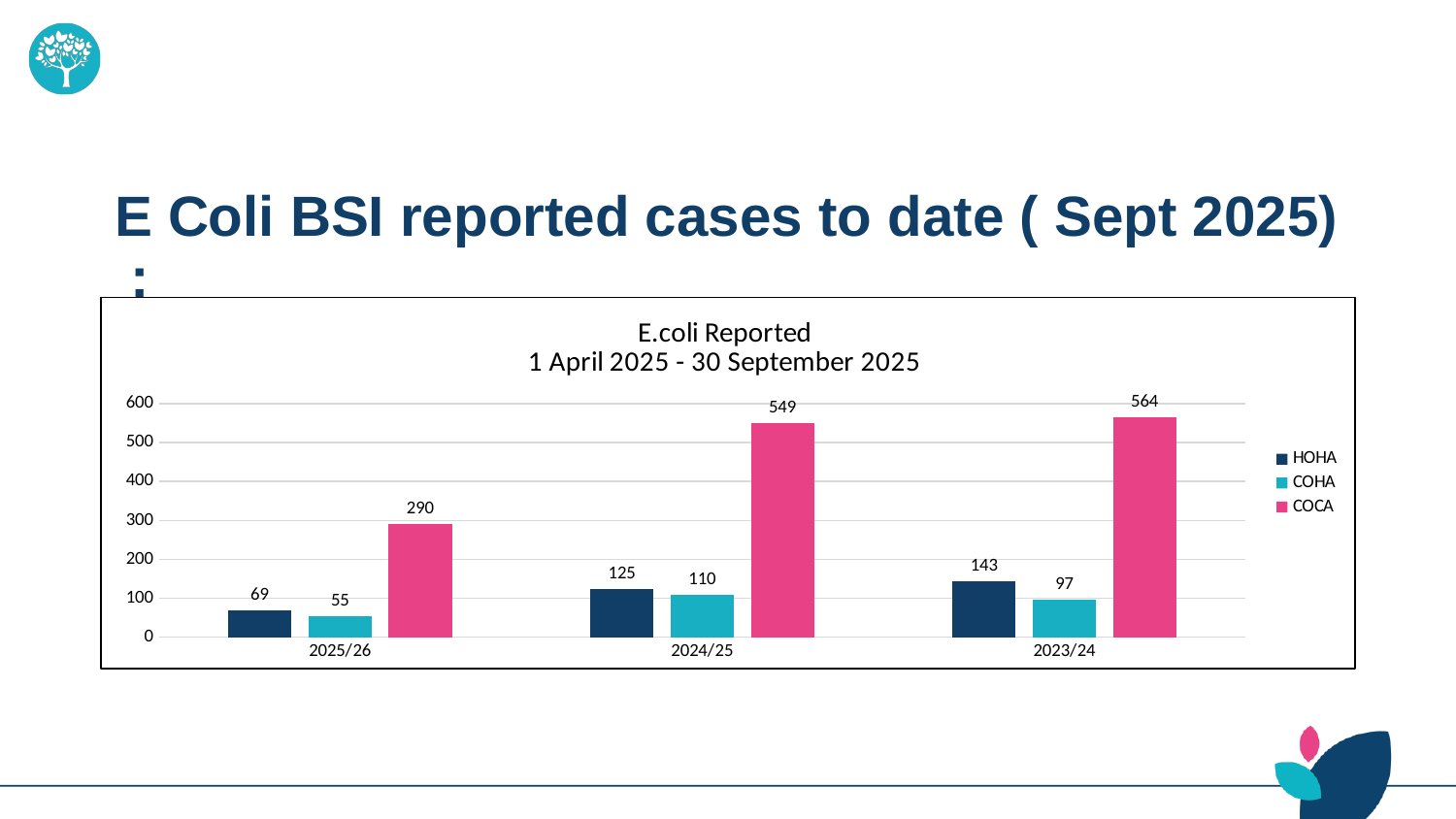
Which year has the lowest HOHA value? 2025/26 What is the COHA value for 2023/24? 97 Is the COCA value for 2025/26 greater or less than 200? greater What kind of chart is shown? bar chart What is the difference between the COCA values for 2023/24 and 2024/25? 15 What is the COCA value for 2024/25? 549 Which is larger, the HOHA value for 2024/25 or the COHA value for 2024/25? HOHA value for 2024/25 What is the title of the chart? E.coli Reported 1 April 2025 - 30 September 2025 How many series does the legend list? 3 What is the HOHA value for 2025/26? 69 How many year categories are shown on the x axis? 3 Which year has the highest COCA value? 2023/24